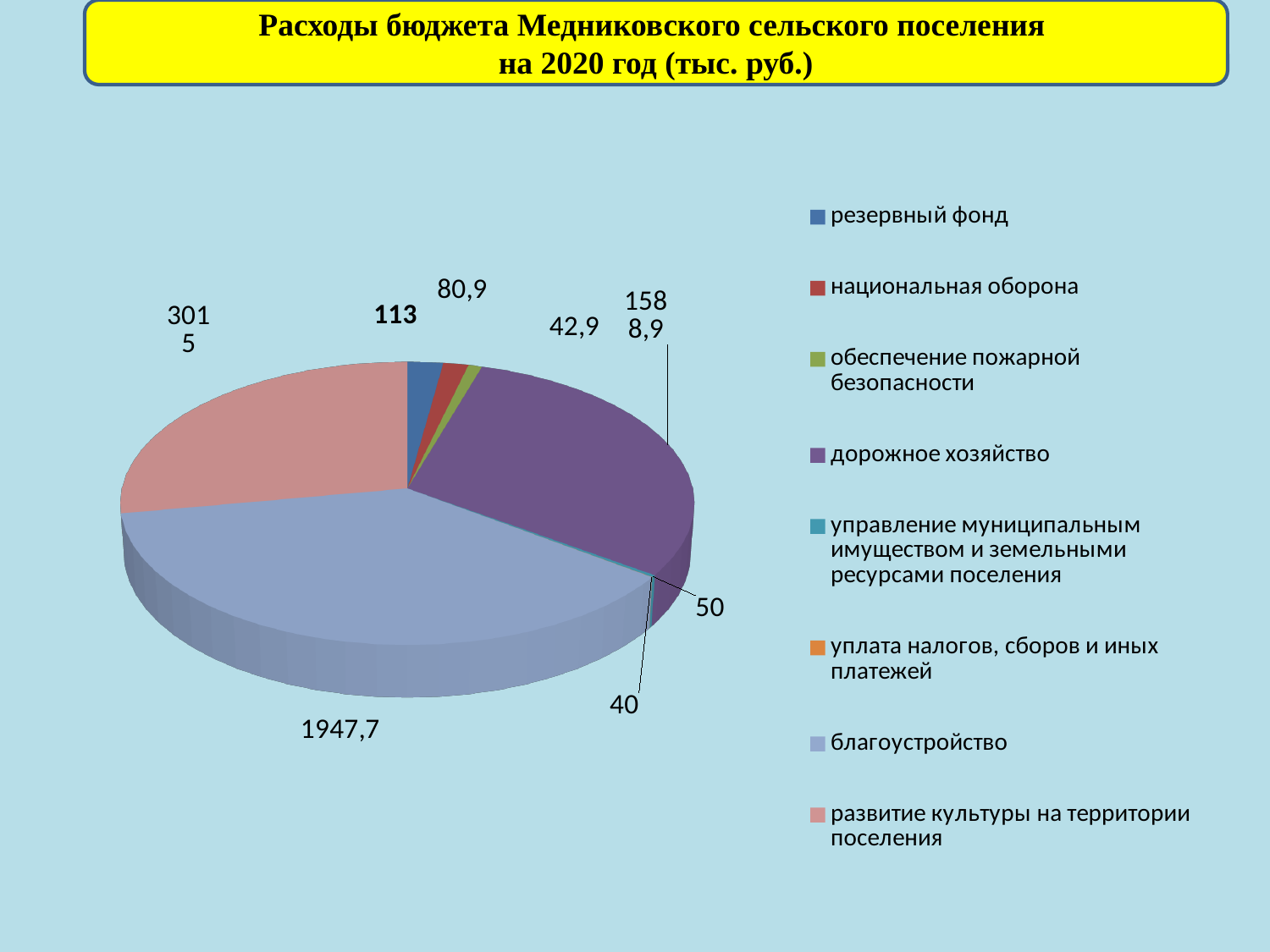
Which slice is larger in the pie chart: дорожное хозяйство or национальная оборона? дорожное хозяйство How many categories does the legend of the pie chart list? 8 What is the title of the slide with the pie chart? Расходы бюджета Медниковского сельского поселения на 2020 год (тыс. руб.) Which slice is larger in the pie chart: резервный фонд or развитие культуры на территории поселения? развитие культуры на территории поселения Which slice is larger in the pie chart: благоустройство or дорожное хозяйство? благоустройство What value is labelled on the благоустройство slice of the pie chart? 1947,7 Which legend entry is shown in purple in the pie chart? дорожное хозяйство Which category has the largest slice in the pie chart? благоустройство What kind of chart is shown on the slide? pie chart Is the value for благоустройство in the pie chart greater or less than 1000? greater